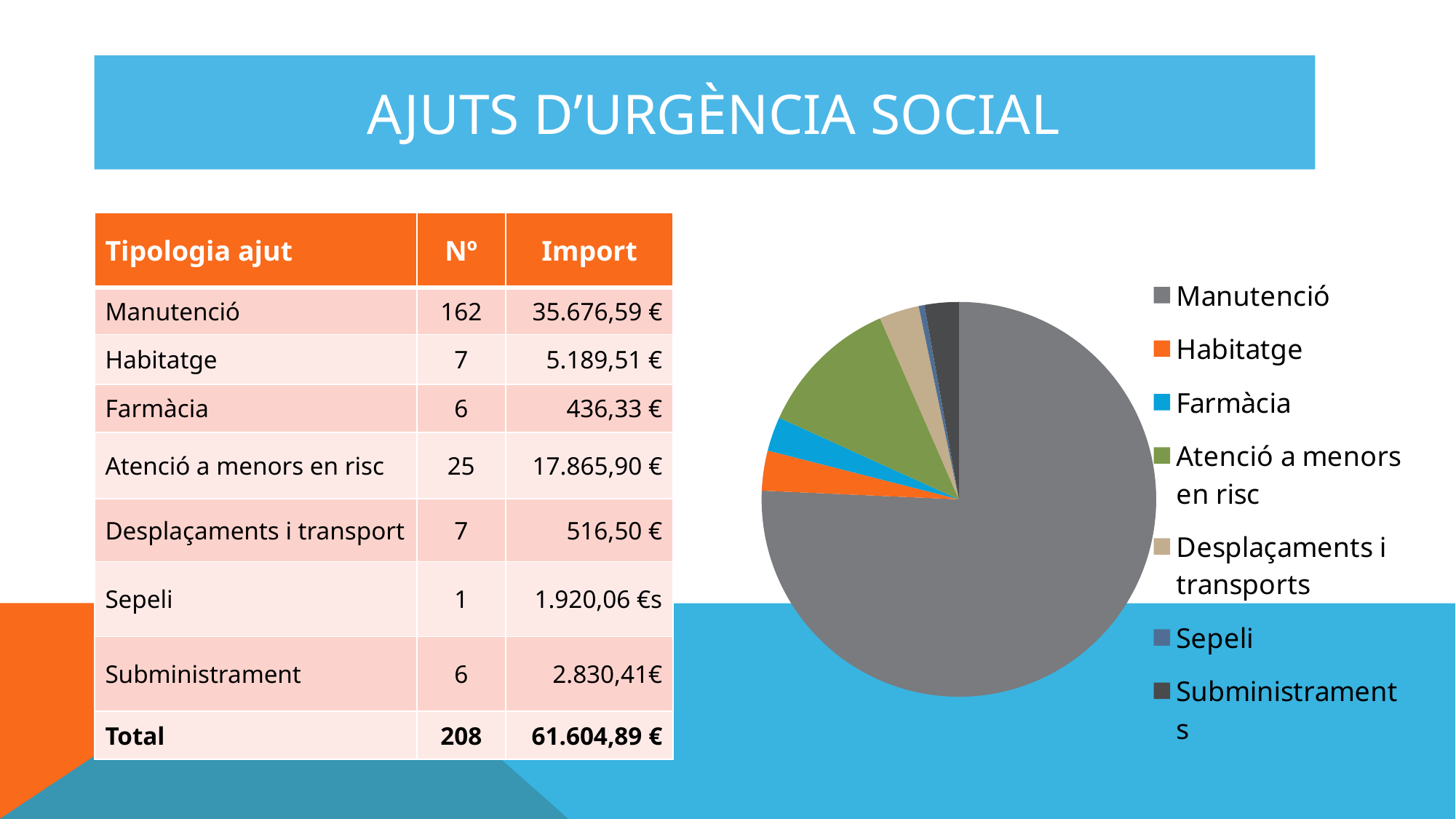
Which legend entry in the pie chart is shown in orange? Habitatge In the pie chart, which slice is larger: Manutenció or Atenció a menors en risc? Manutenció What kind of chart is shown on the right of the slide? pie chart In the pie chart, which slice is larger: Atenció a menors en risc or Sepeli? Atenció a menors en risc Which category has the second-largest slice in the pie chart? Atenció a menors en risc What colour is the Manutenció slice in the pie chart? grey How many categories does the pie chart's legend list? 7 In the pie chart, which slice is larger: Atenció a menors en risc or Habitatge? Atenció a menors en risc Which category has the smallest slice in the pie chart? Sepeli Which category has the largest slice in the pie chart? Manutenció